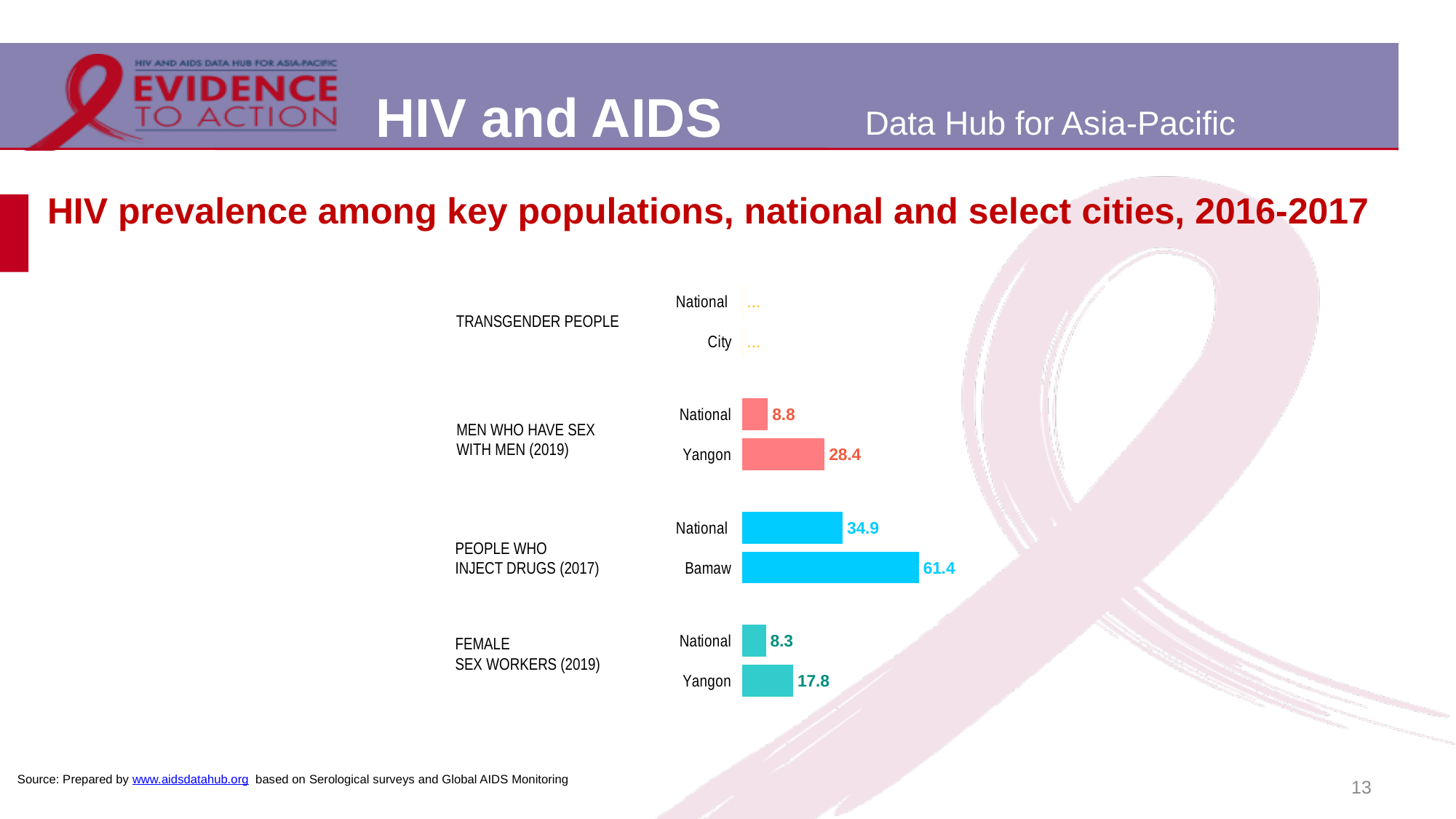
Which bar shows the lowest plotted HIV prevalence on the chart? Female sex workers, National How many key population groups are listed on the chart? 4 What is the HIV prevalence among men who have sex with men at the national level? 8.8 What is the HIV prevalence among men who have sex with men in Yangon? 28.4 Which bar shows the highest HIV prevalence on the chart? People who inject drugs, Bamaw Which is larger: the Yangon HIV prevalence among men who have sex with men or the national HIV prevalence among people who inject drugs? National HIV prevalence among people who inject drugs What values are shown for transgender people on the chart? ... (no data) What kind of chart is shown on the slide? Bar chart What is the difference between the Yangon and national HIV prevalence among female sex workers? 9.5 What is the difference between the Bamaw and national HIV prevalence among people who inject drugs? 26.5 What is the HIV prevalence among people who inject drugs in Bamaw? 61.4 What is the national HIV prevalence among female sex workers? 8.3